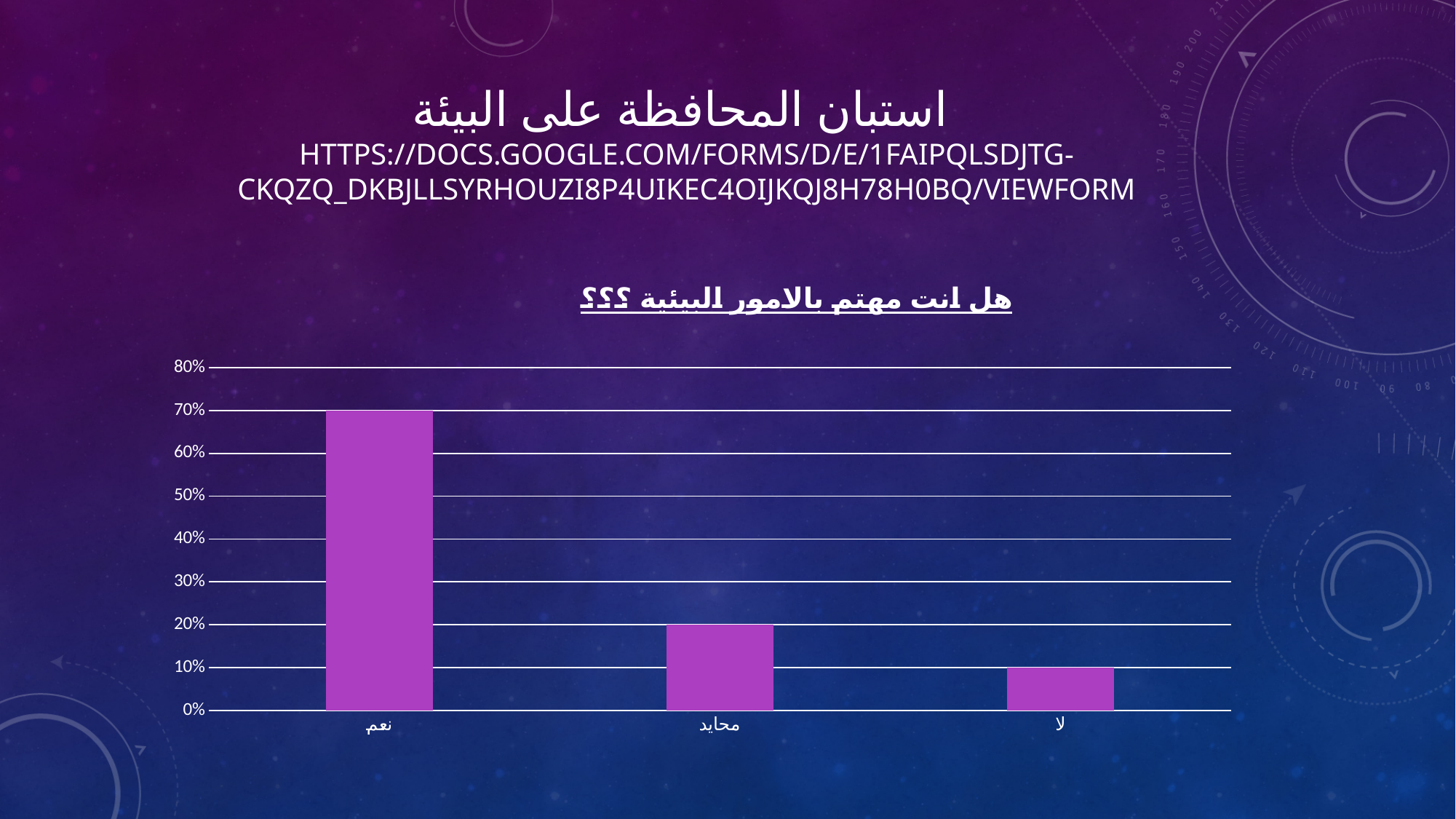
What is the difference between the values for محايد and لا? 10% What is the difference between the values for نعم and محايد? 50% How many categories are shown on the x axis of the chart? 3 What type of chart is shown on the slide? Bar chart Which category has the highest value in the chart? نعم Which category has the lowest value in the chart? لا What is the title of the chart? هل انت مهتم بالامور البيئية ؟؟؟ Is the value for نعم greater or less than 50%? greater Which is larger, the value for محايد or the value for لا? محايد What is the value for نعم in the chart? 70% What is the value for لا in the chart? 10% What is the value for محايد in the chart? 20%